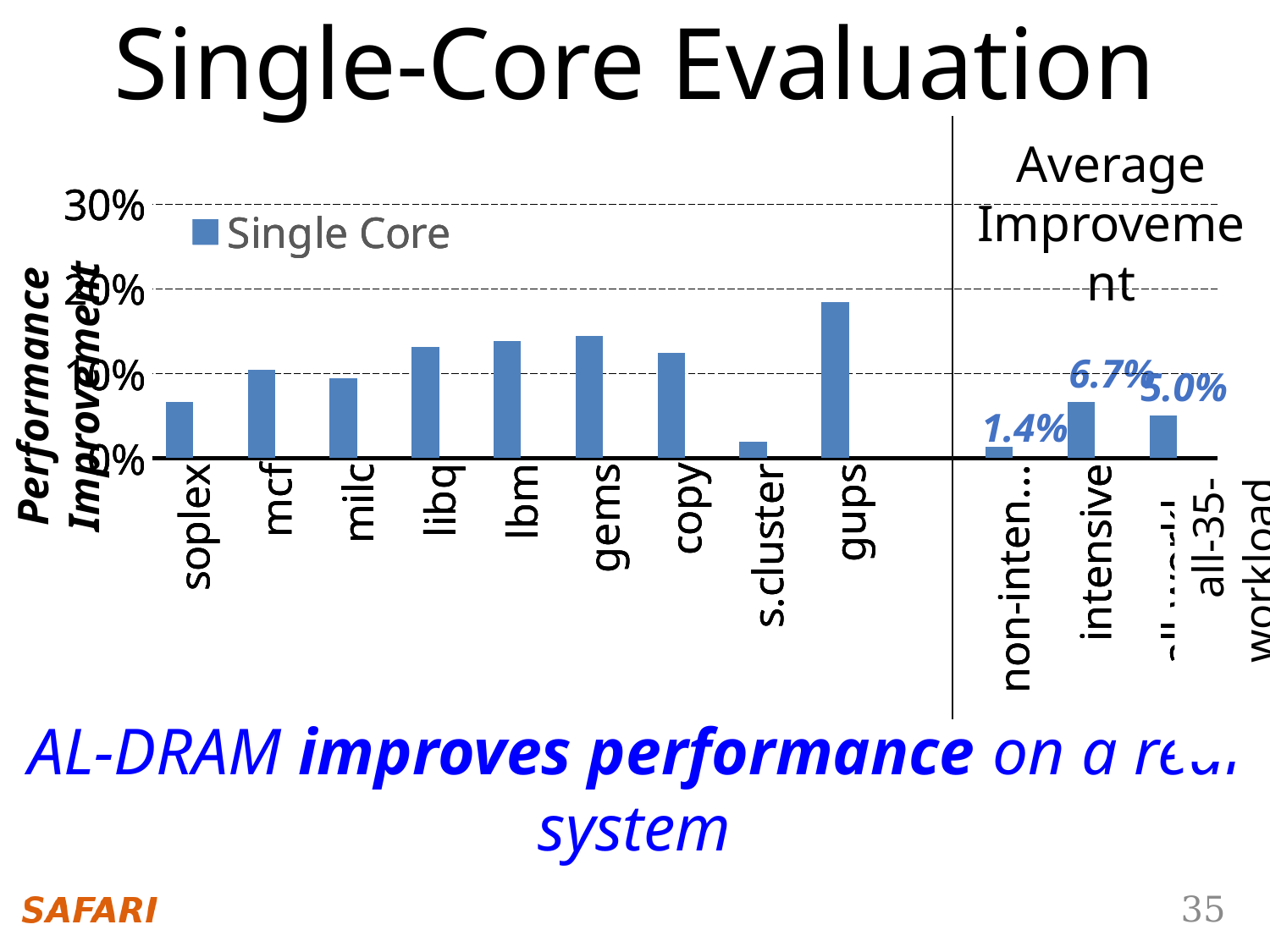
How many series does the legend list? 1 Is the performance improvement for soplex greater or less than 10%? less What is the performance improvement shown for the intensive workload group? 6.7% Which has a larger performance improvement, gups or copy? gups What is the performance improvement shown for the non-intensive workload group? 1.4% What is the average performance improvement shown for the all-35-workload group? 5.0% What type of chart is shown on the slide? Bar chart Is the performance improvement for gups greater or less than 10%? greater Which benchmark has the highest performance improvement bar? gups Among the nine benchmarks to the left of the vertical divider, which has the lowest performance improvement? s.cluster What is the difference between the intensive and non-intensive average improvements? 5.3% How many bars are plotted in the chart? 12